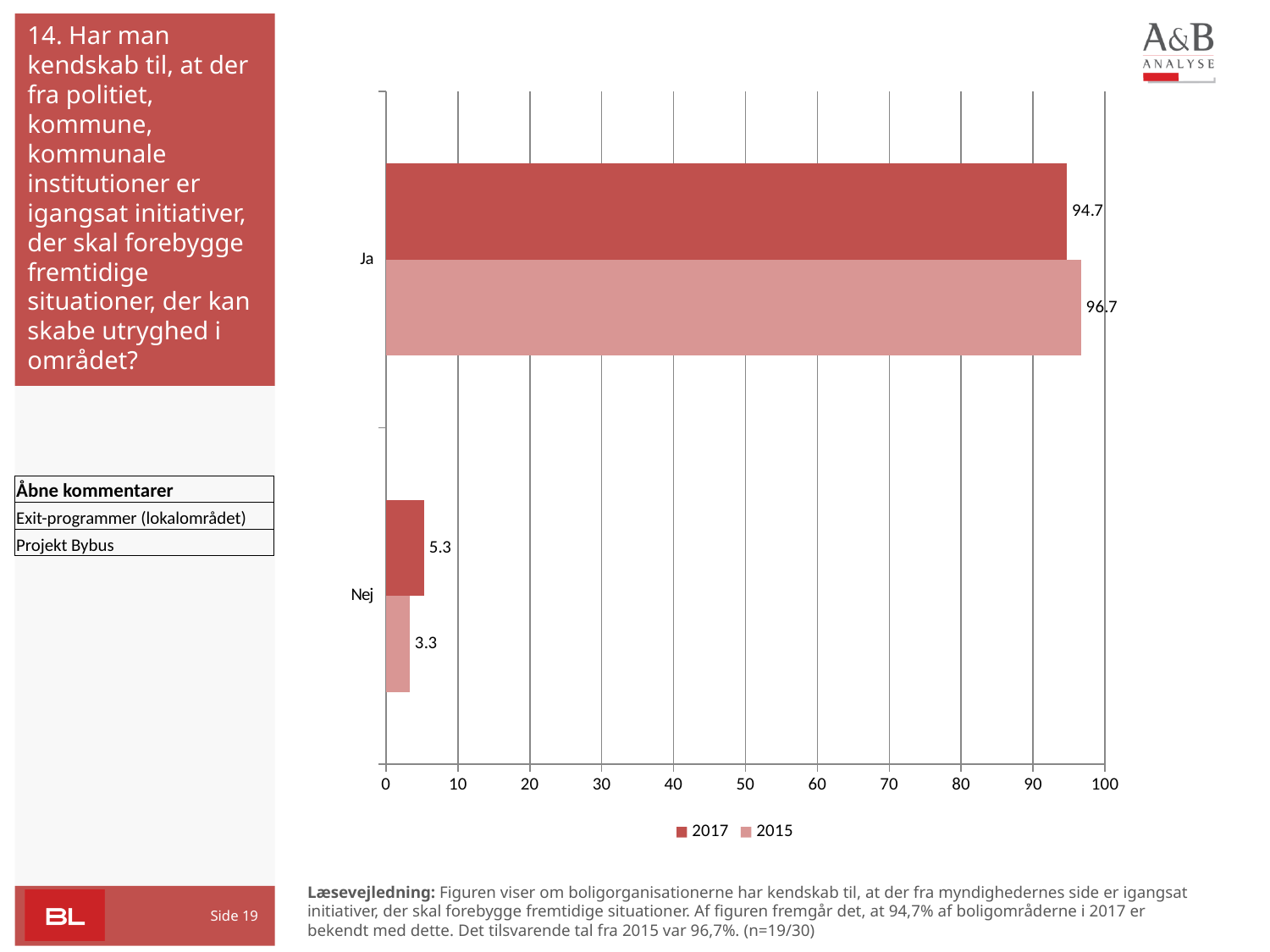
How many series does the legend list? 2 How many categories are shown on the chart? 2 Which category has the lowest value in the 2015 series? Nej What is the difference between the 2015 and 2017 values for Ja? 2 What is the value for Nej in the 2015 series? 3.3 Which series has the larger value for Ja, 2017 or 2015? 2015 Which category has the highest value in the 2017 series? Ja What is the value for Ja in the 2017 series? 94.7 What is the difference between the 2017 and 2015 values for Nej? 2 What is the value for Nej in the 2017 series? 5.3 What is the value for Ja in the 2015 series? 96.7 What kind of chart is shown on the slide? Bar chart